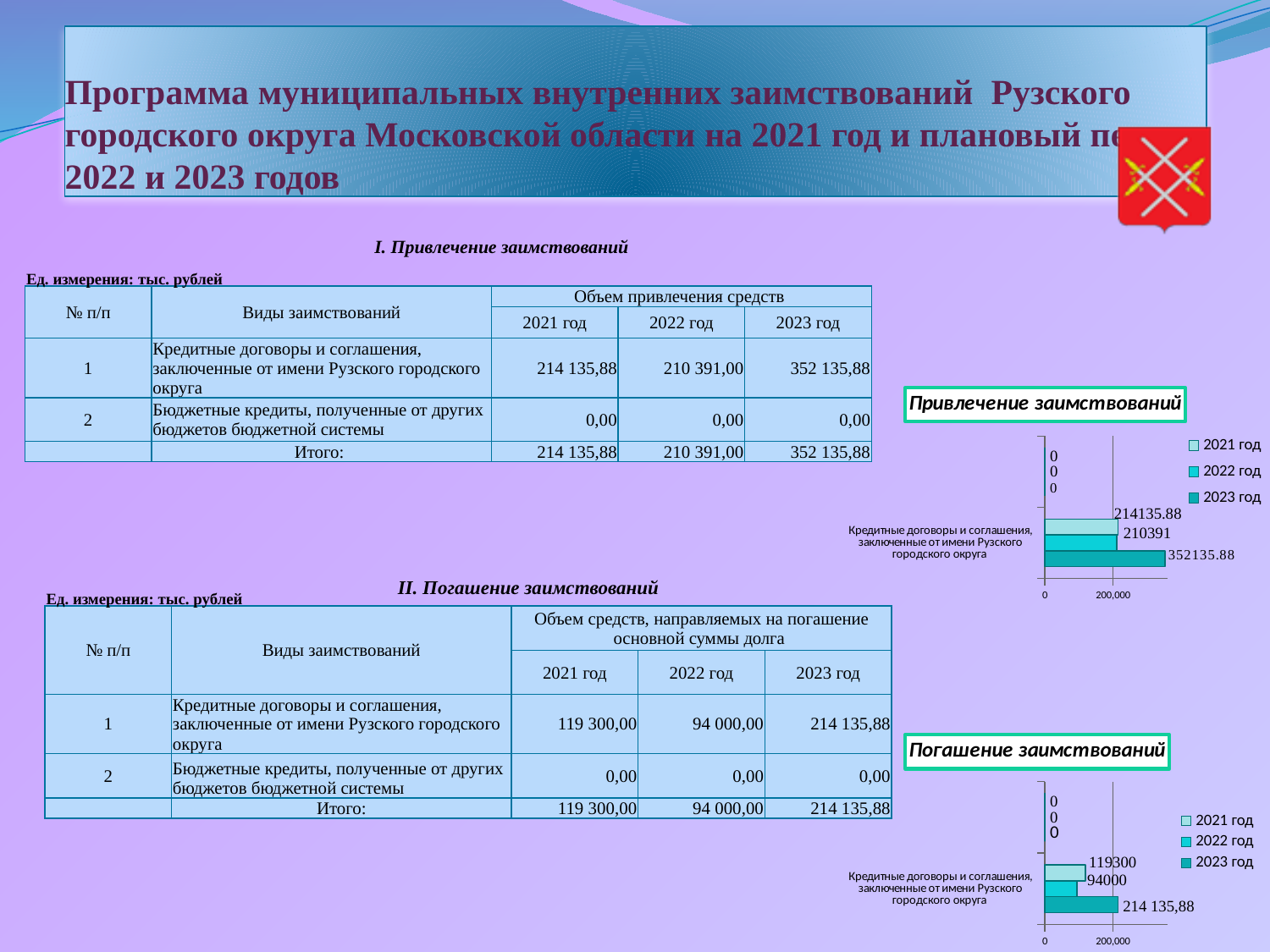
In the chart titled "Погашение заимствований", what is the value for 2021 год for Кредитные договоры и соглашения, заключенные от имени Рузского городского округа? 119300 In the chart titled "Привлечение заимствований", what is the value for 2023 год for Кредитные договоры и соглашения, заключенные от имени Рузского городского округа? 352135.88 In the chart titled "Привлечение заимствований", which year has the highest value for Кредитные договоры и соглашения, заключенные от имени Рузского городского округа? 2023 год In the chart titled "Погашение заимствований", what is the value for 2022 год for Кредитные договоры и соглашения, заключенные от имени Рузского городского округа? 94000 In the chart titled "Привлечение заимствований", what is the value for 2022 год for Кредитные договоры и соглашения, заключенные от имени Рузского городского округа? 210391 In the chart titled "Погашение заимствований", what is the value for 2023 год for Кредитные договоры и соглашения, заключенные от имени Рузского городского округа? 214 135,88 In the chart titled "Погашение заимствований", which year has the lowest value for Кредитные договоры и соглашения, заключенные от имени Рузского городского округа? 2022 год In the chart titled "Погашение заимствований", is the value for 2022 год greater or less than 200,000? less What kind of chart is the chart titled "Погашение заимствований"? bar chart In the chart titled "Привлечение заимствований", is the value for 2023 год greater or less than 200,000? greater In the chart titled "Привлечение заимствований", how many series does the legend list? 3 In the chart titled "Привлечение заимствований", what is the value for 2021 год for Кредитные договоры и соглашения, заключенные от имени Рузского городского округа? 214135.88